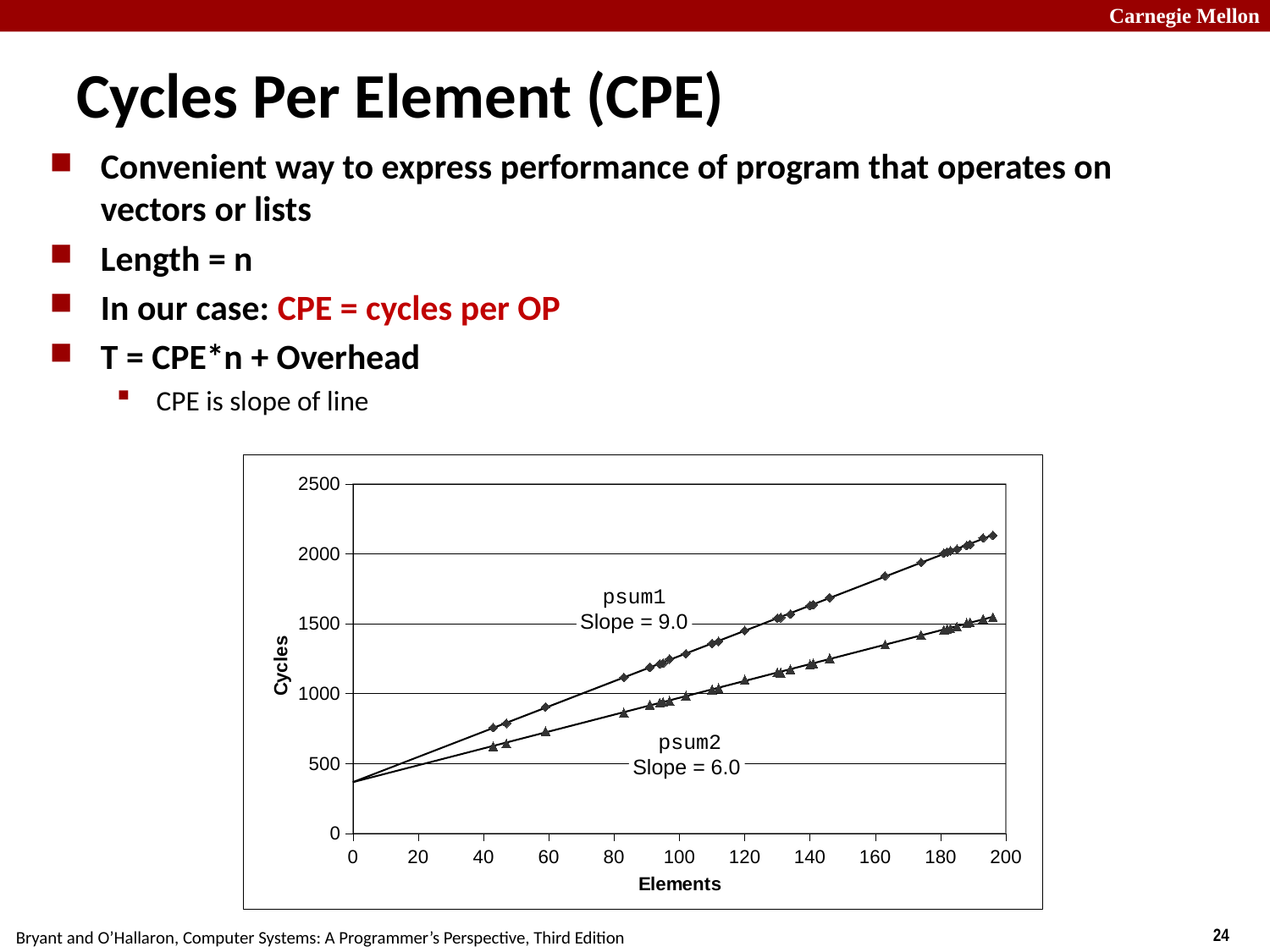
What is the difference between the slope of psum1 and the slope of psum2? 3.0 Is the value for psum2 at 160 elements greater or less than 1500 cycles? less What is the label of the y axis of the chart? Cycles What kind of chart is shown on the slide? scatter chart What is the slope of the psum1 line? 9.0 What is the label of the x axis of the chart? Elements What is the slope of the psum2 line? 6.0 Is the value for psum1 at 200 elements greater or less than 2000 cycles? greater Do the cycle counts for psum1 rise or fall as the number of elements increases? rise Which series has the larger slope, psum1 or psum2? psum1 How many data series are plotted on the chart? 2